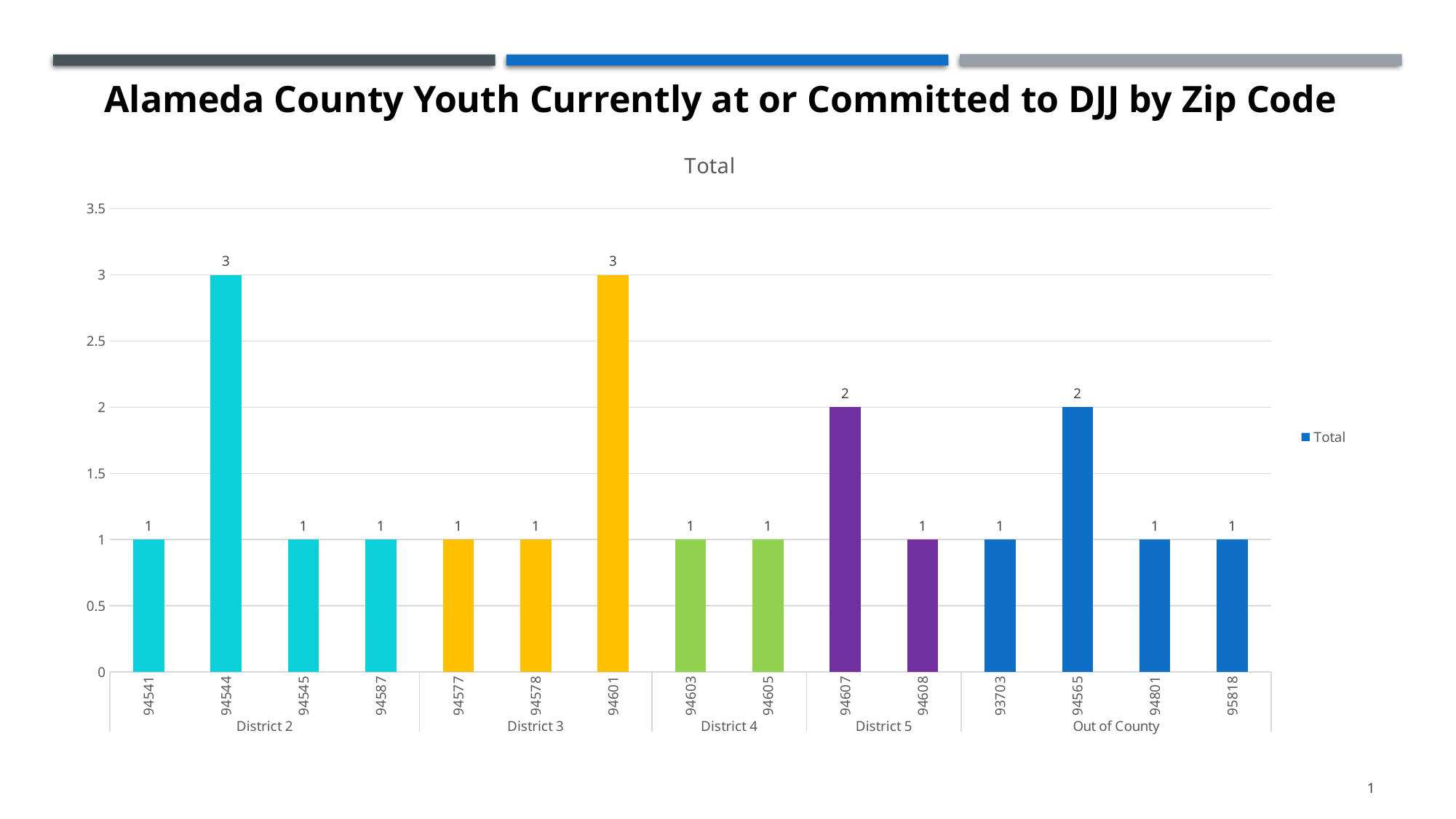
Which has a larger value, 94607 or 94608? 94607 What is the value for zip code 94603? 1 What is the difference between the values for 94544 and 94545? 2 What is the highest value shown on the chart? 3 How many series does the legend list? 1 What is the value for zip code 94565? 2 Which zip code in District 3 has the highest value? 94601 What is the value for zip code 94544? 3 What kind of chart is shown on the slide? Bar chart What is the value for zip code 94607? 2 How many zip codes are shown on the x axis? 15 How many district groups are labelled on the x axis? 5